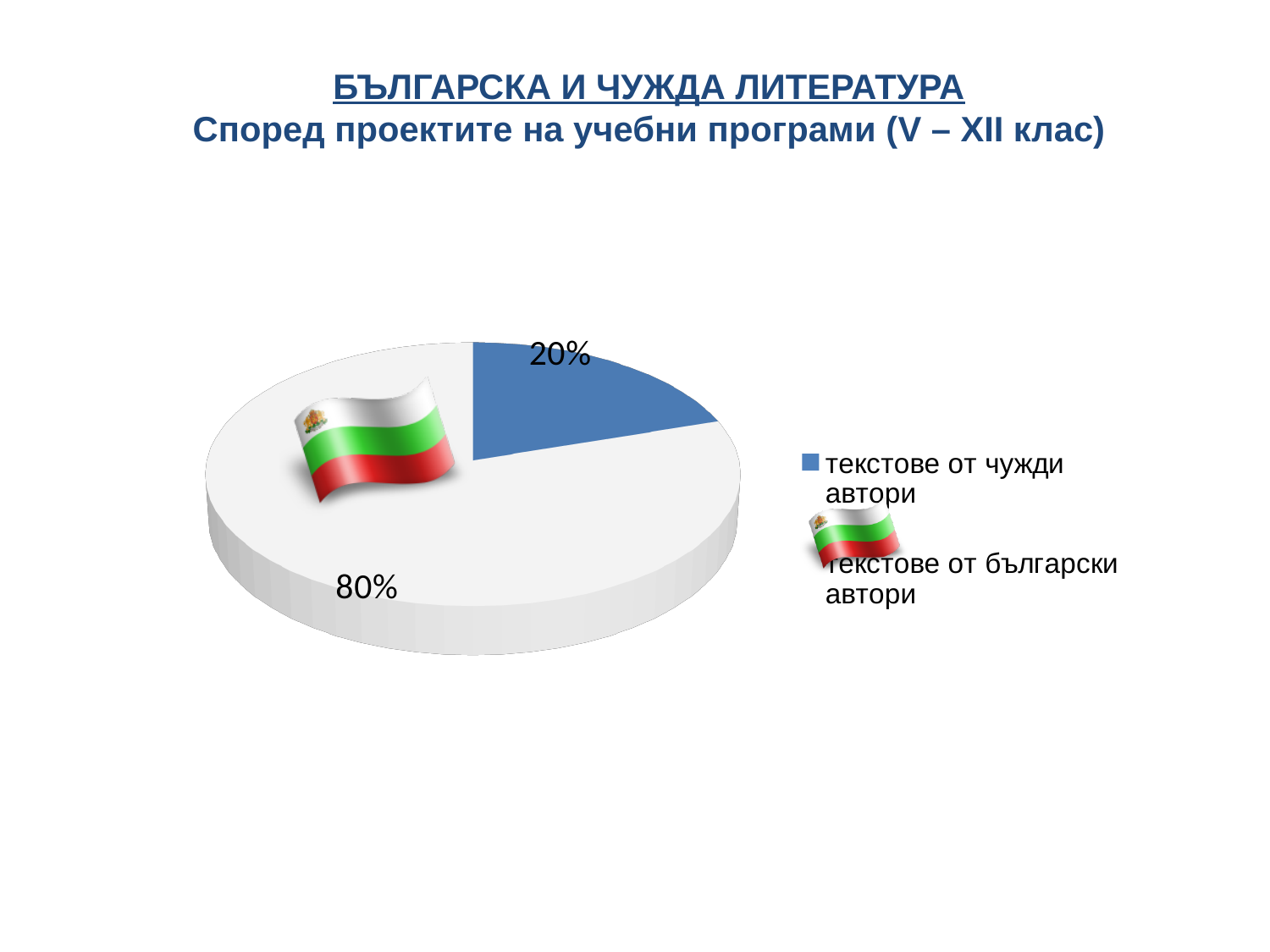
How many slices does the pie chart have? 2 What colour is the slice for texts by foreign authors (текстове от чужди автори)? blue What is the difference in percentage points between the slice for Bulgarian authors and the slice for foreign authors? 60 Which category has the smallest slice of the pie? текстове от чужди автори Which is larger: the slice for texts by foreign authors or the slice for texts by Bulgarian authors? текстове от български автори What kind of chart is shown on the slide? pie chart What is the underlined title at the top of the slide? БЪЛГАРСКА И ЧУЖДА ЛИТЕРАТУРА Which category has the largest slice of the pie? текстове от български автори What share of the pie is labelled for texts by Bulgarian authors (текстове от български автори)? 80% How many entries does the legend list? 2 What share of the pie is labelled for texts by foreign authors (текстове от чужди автори)? 20%